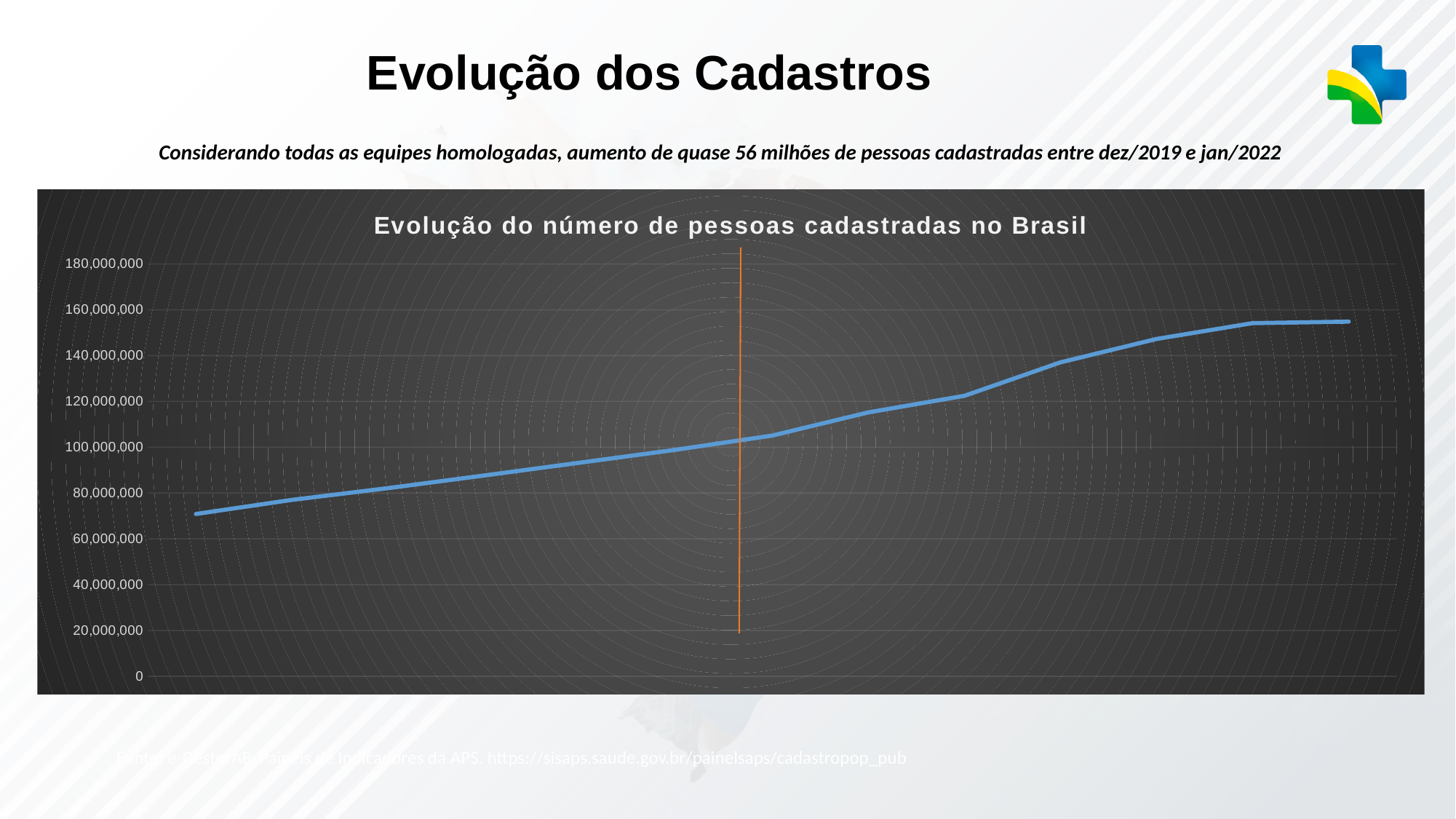
Is the value at the point where the orange vertical line crosses the blue line greater or less than 120,000,000? less Is the value at the leftmost point of the line greater or less than 80,000,000? less What kind of chart is shown on the slide? line chart Is the value at the leftmost point of the line greater or less than 60,000,000? greater Do the values in the chart rise or fall from left to right along the x axis? rise Which point of the line has the highest value, the leftmost or the rightmost? rightmost What is the highest value labelled on the vertical axis? 180,000,000 What is the title of the chart? Evolução do número de pessoas cadastradas no Brasil